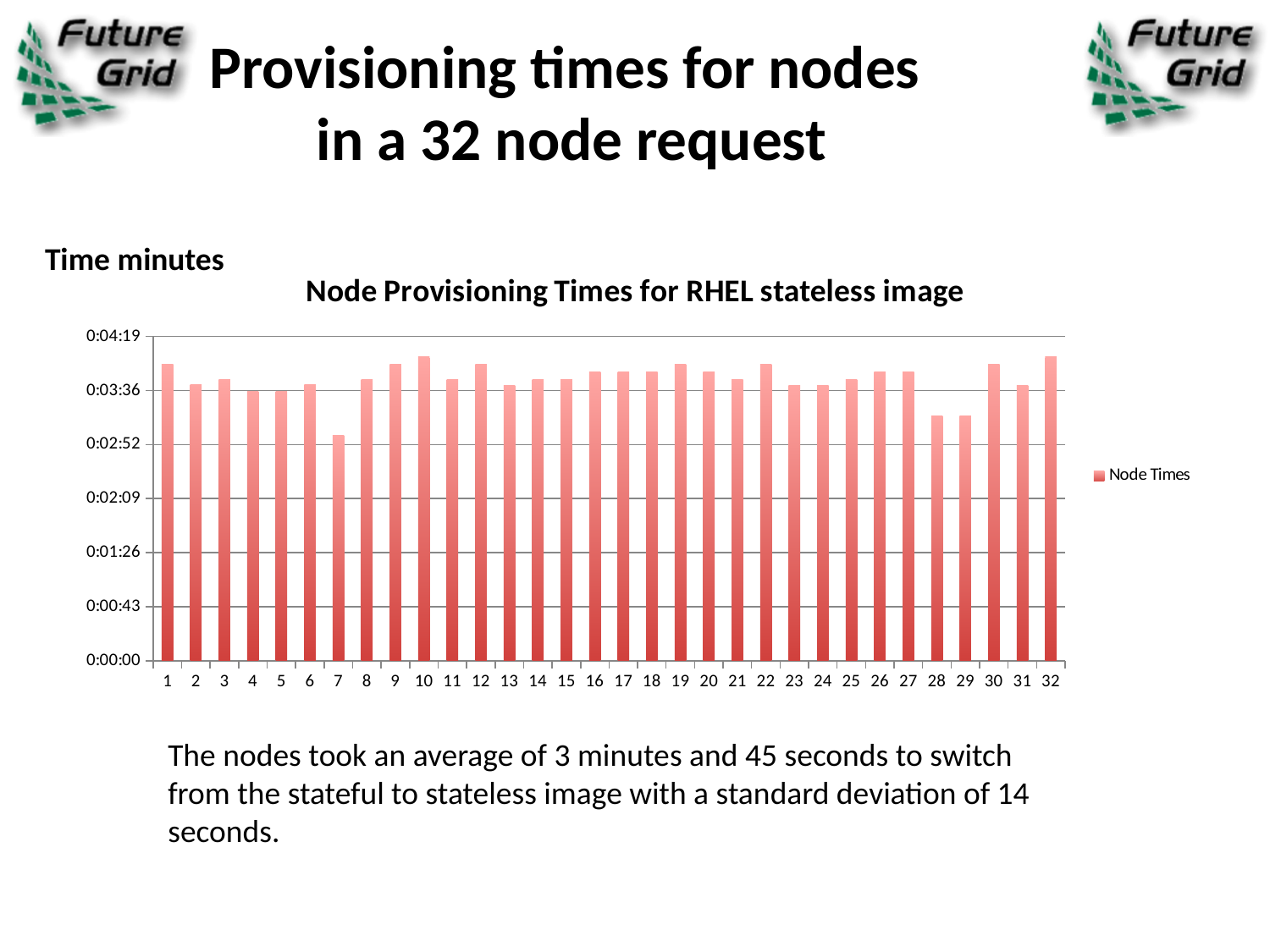
Which node has the lowest provisioning time? 7 How many nodes (categories) are plotted along the x axis? 32 What kind of chart is shown on the slide? Bar chart Is the value for node 7 greater or less than 0:02:52? greater Is the value for node 28 greater or less than 0:03:36? less Which has the larger provisioning time, node 10 or node 29? Node 10 Which has the larger provisioning time, node 1 or node 7? Node 1 What is the name of the series shown in the legend? Node Times What is the title of the chart? Node Provisioning Times for RHEL stateless image Is the value for node 1 greater or less than 0:03:36? greater How many series does the legend list? 1